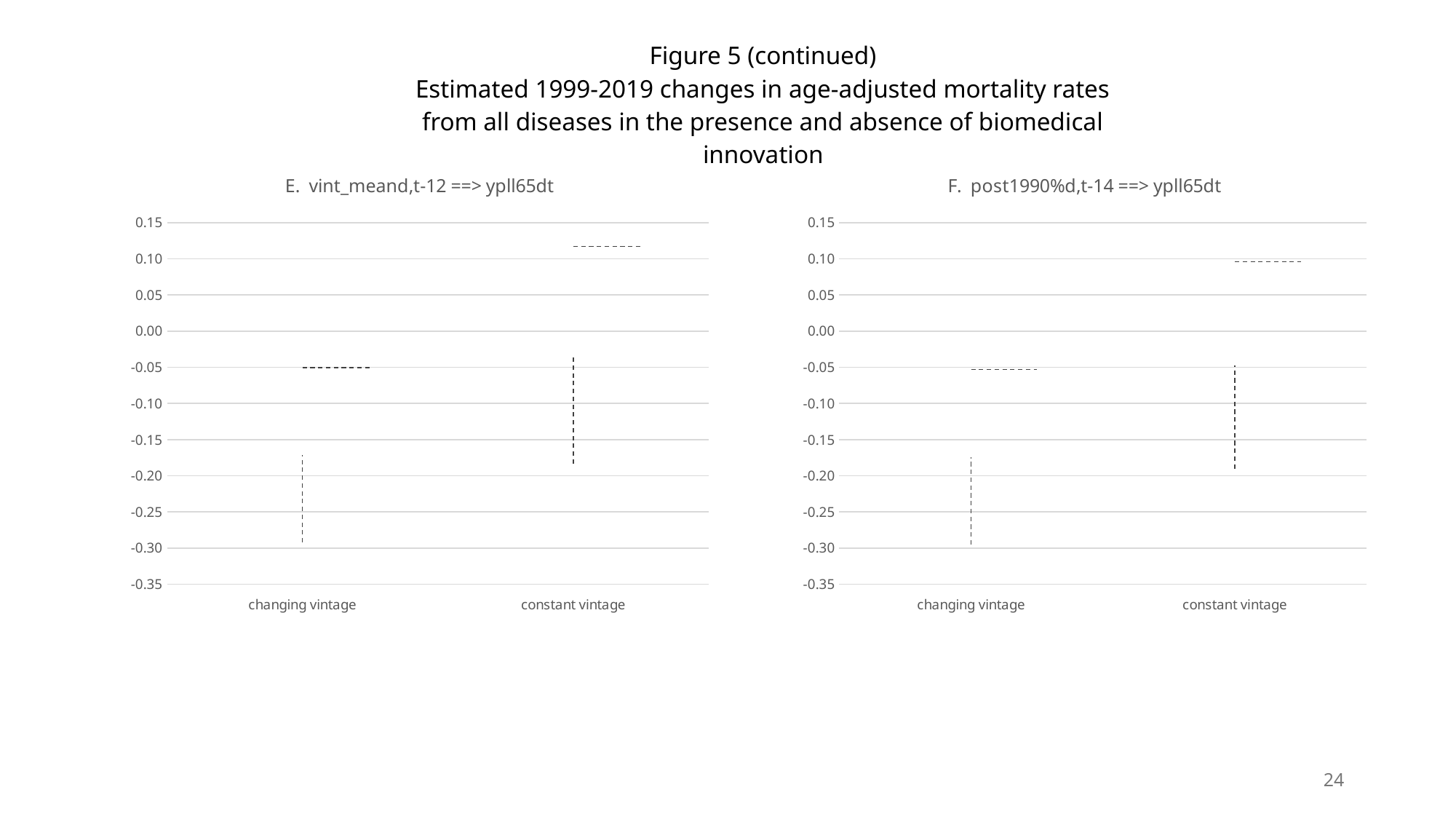
In chart E (vint_meand,t-12 ==> ypll65dt), is the bottom of the vertical dashed line for constant vintage greater or less than -0.15? less What are the two category labels on the x axis of chart F (post1990%d,t-14 ==> ypll65dt)? changing vintage, constant vintage In chart F (post1990%d,t-14 ==> ypll65dt), is the horizontal dashed marker for changing vintage greater or less than 0.00? less In chart F (post1990%d,t-14 ==> ypll65dt), which category has the higher horizontal dashed marker, changing vintage or constant vintage? constant vintage In chart E (vint_meand,t-12 ==> ypll65dt), which category has the higher horizontal dashed marker, changing vintage or constant vintage? constant vintage In chart E (vint_meand,t-12 ==> ypll65dt), is the bottom of the vertical dashed line for changing vintage greater or less than -0.25? less How many categories are shown on the x axis of chart E (vint_meand,t-12 ==> ypll65dt)? 2 What is the lowest value labelled on the y axis of chart E (vint_meand,t-12 ==> ypll65dt)? -0.35